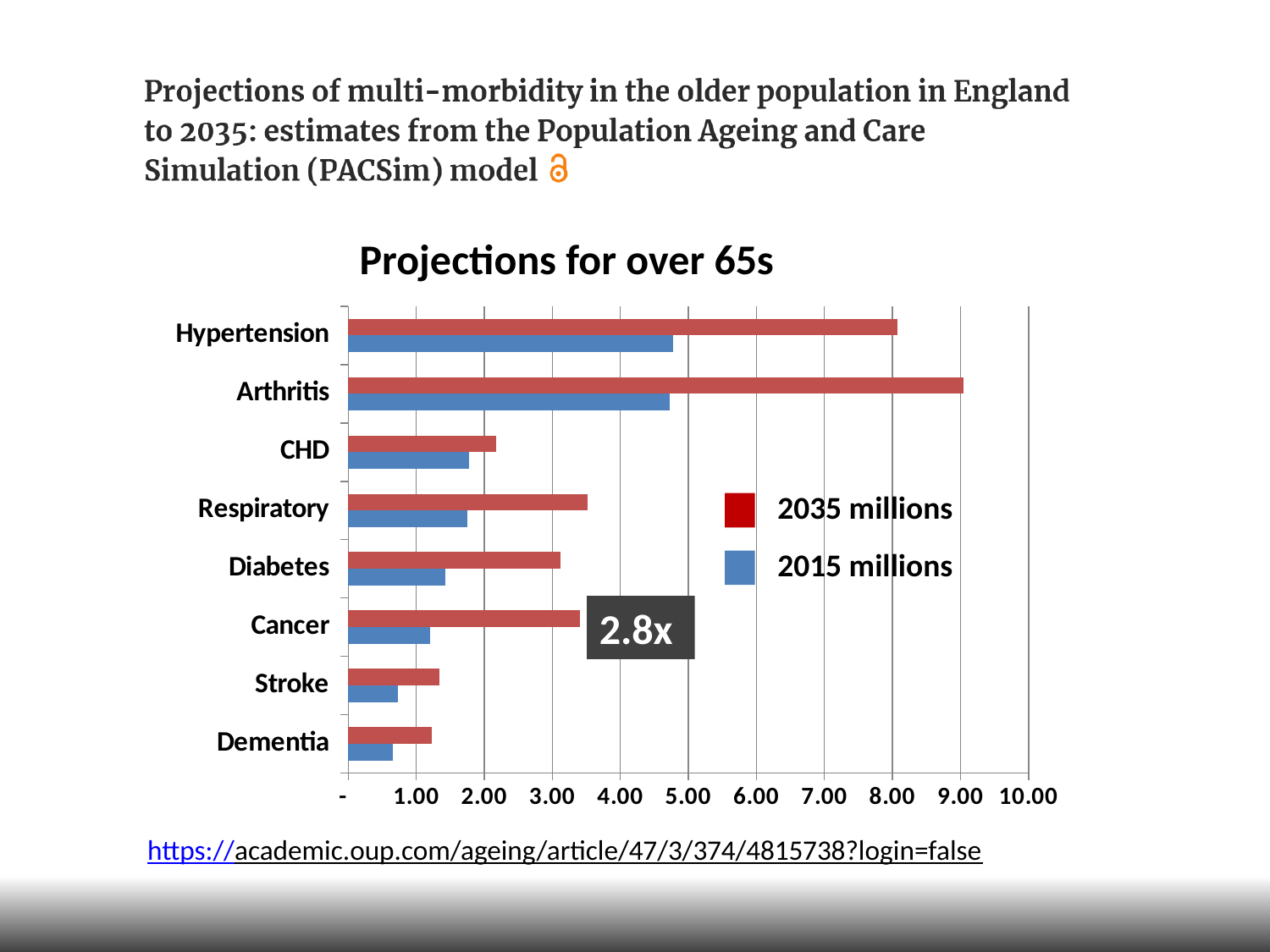
Is the 2015 millions value for Dementia greater or less than 1.00? less What multiplier is shown in the dark box annotation next to the Cancer bars? 2.8x Which is larger: the 2015 millions value for Hypertension or for Stroke? Hypertension Which is larger: the 2035 millions value for Cancer or for CHD? Cancer What kind of chart is shown on the slide? bar chart Is the 2035 millions value for Respiratory greater or less than 3.00? greater How many conditions (categories) are plotted in the 'Projections for over 65s' chart? 8 What are the two legend entries in the 'Projections for over 65s' chart? 2035 millions and 2015 millions Which condition has the highest 2035 millions value? Arthritis How many series does the legend of the 'Projections for over 65s' chart list? 2 Is the 2015 millions value for Cancer greater or less than 2.00? less